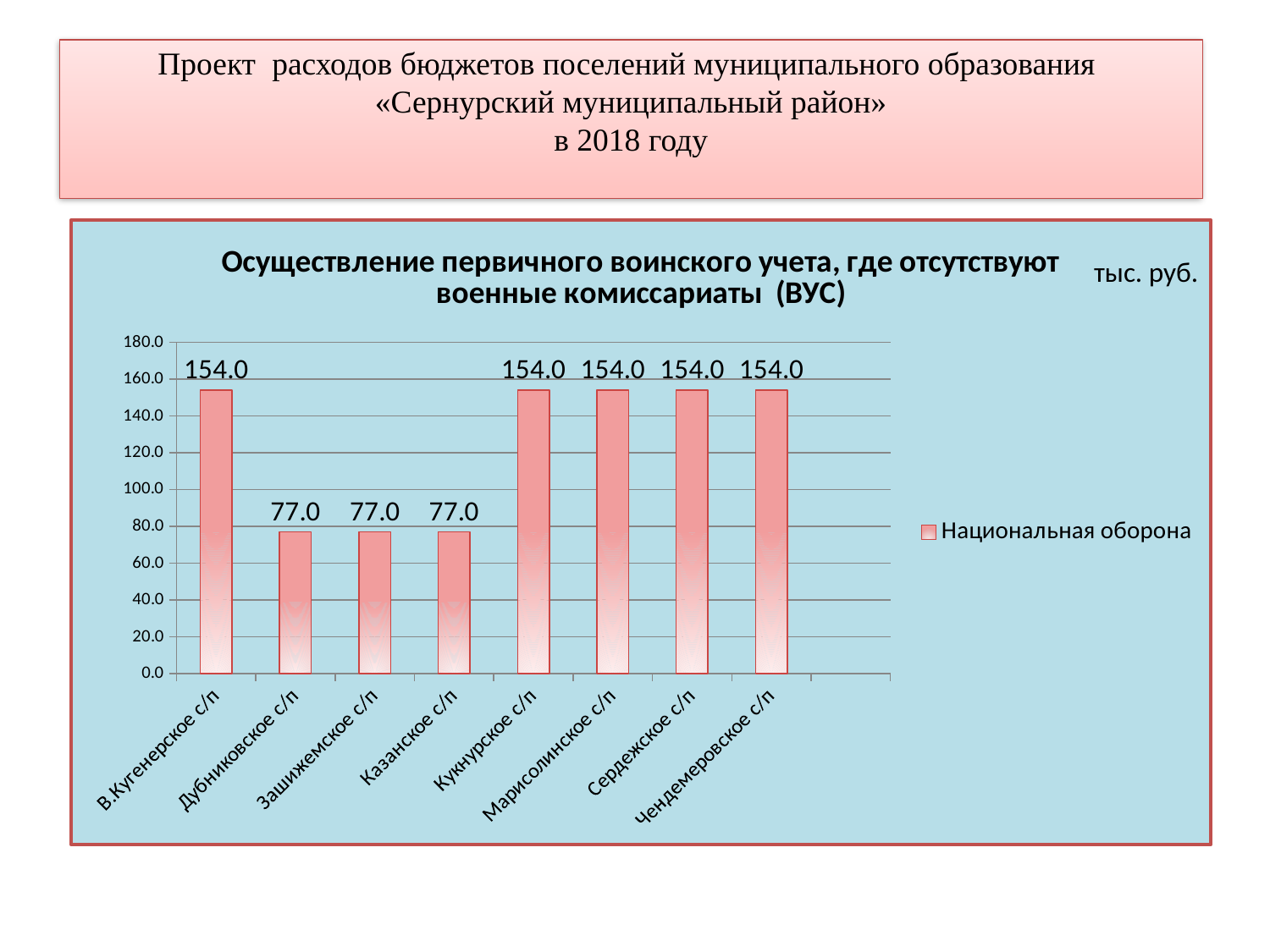
What is the value for Кукнурское с/п? 154.0 What is the difference between the value for Сердежское с/п and the value for Дубниковское с/п? 77.0 How many series does the legend list? 1 What is the value for Казанское с/п? 77.0 How many categories are shown on the x axis of the chart? 8 What series name is shown in the chart legend? Национальная оборона What kind of chart is shown on the slide? bar chart What is the value for Чендемеровское с/п? 154.0 Is the value for Зашижемское с/п greater or less than 100.0? less What is the value for Дубниковское с/п? 77.0 Which is larger, the value for В.Кугенерское с/п or the value for Зашижемское с/п? В.Кугенерское с/п Is the value for Марисолинское с/п greater or less than 140.0? greater